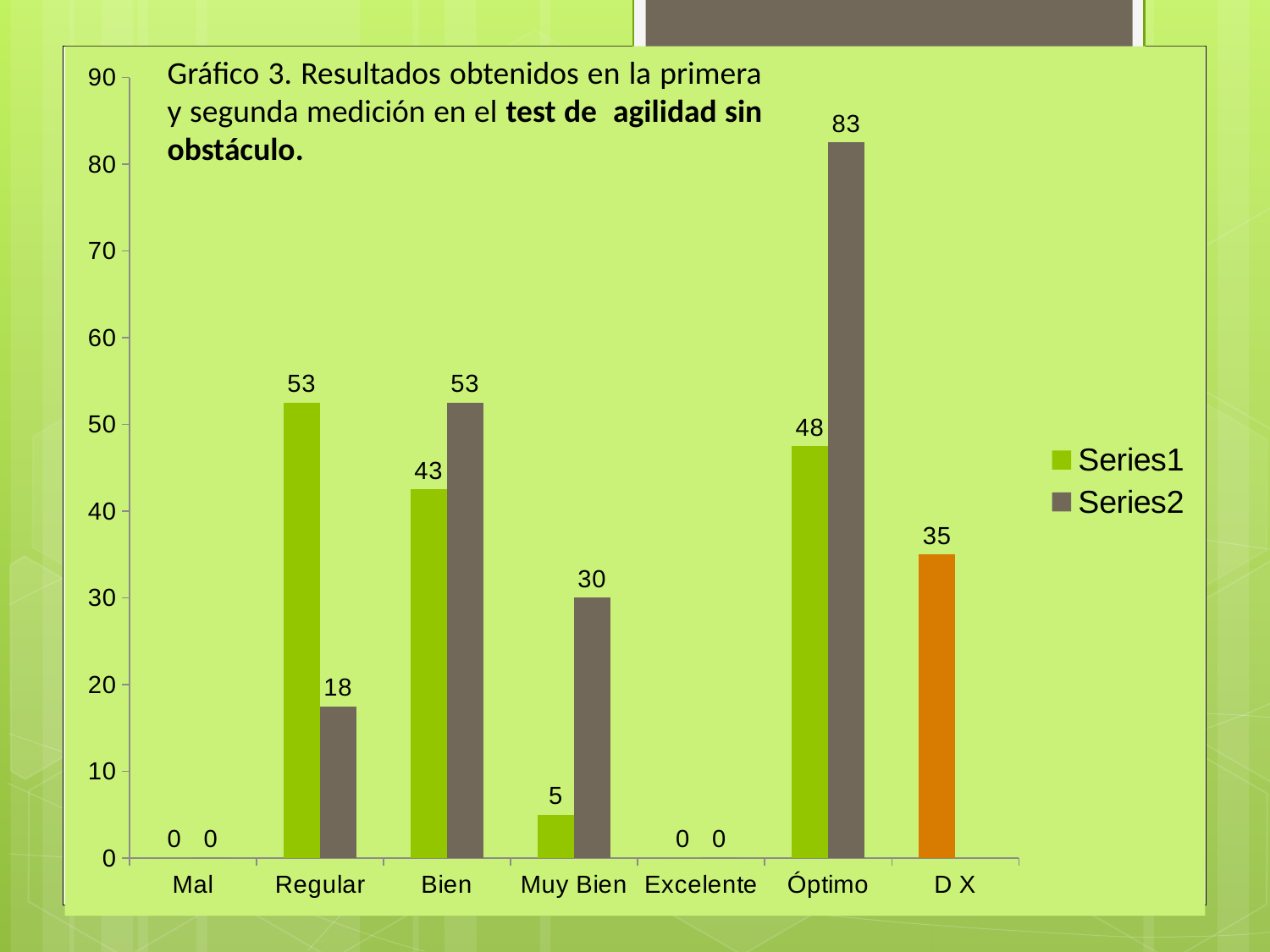
Which category has the highest Series1 value? Regular What is the Series1 value for Regular? 53 How many series does the legend list? 2 Which category has the highest Series2 value? Óptimo For Regular, which series has the larger value, Series1 or Series2? Series1 What is the difference between the Series2 and Series1 values for Óptimo? 35 What is the Series2 value for Óptimo? 83 What is the Series2 value for Muy Bien? 30 What is the Series1 value for Bien? 43 What value is labelled on the bar for D X? 35 How many categories are shown on the x axis? 7 What kind of chart is shown on the slide? Bar chart